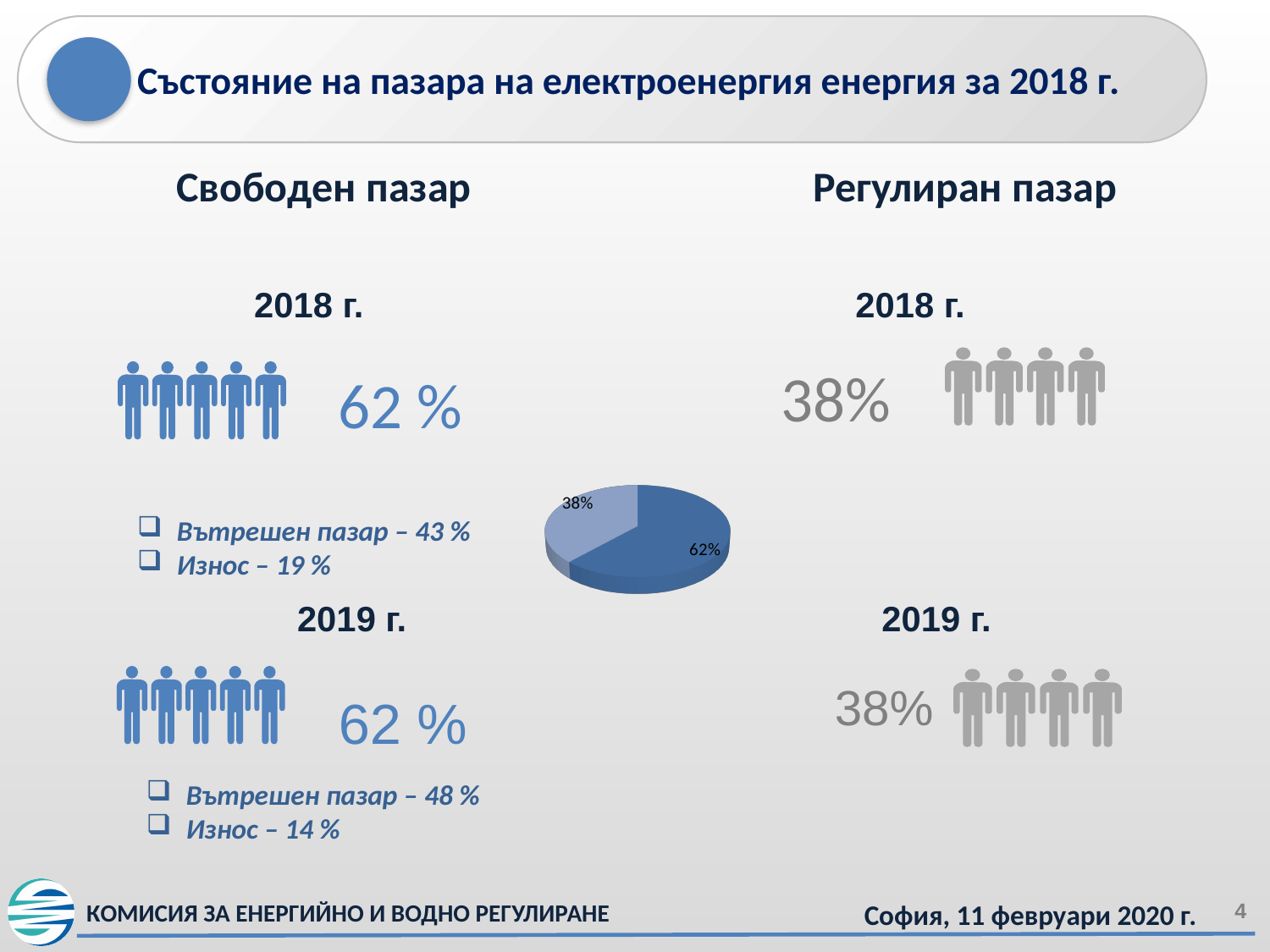
What share of the pie chart does the light blue slice represent? 38% Is the value of the light blue slice of the pie chart greater or less than 50%? less Is the value of the dark blue slice of the pie chart greater or less than 50%? greater What is the difference between the two slices of the pie chart? 24% Which slice of the pie chart is larger, the dark blue one or the light blue one? the dark blue one How many slices does the pie chart have? 2 According to the slide, which market does the 62% slice of the pie chart correspond to? Свободен пазар Does the pie chart have a legend? No What kind of chart is shown in the centre of the slide? pie chart What share of the pie chart does the dark blue slice represent? 62% What is the value of the smaller slice of the pie chart? 38% What is the value of the larger slice of the pie chart? 62%